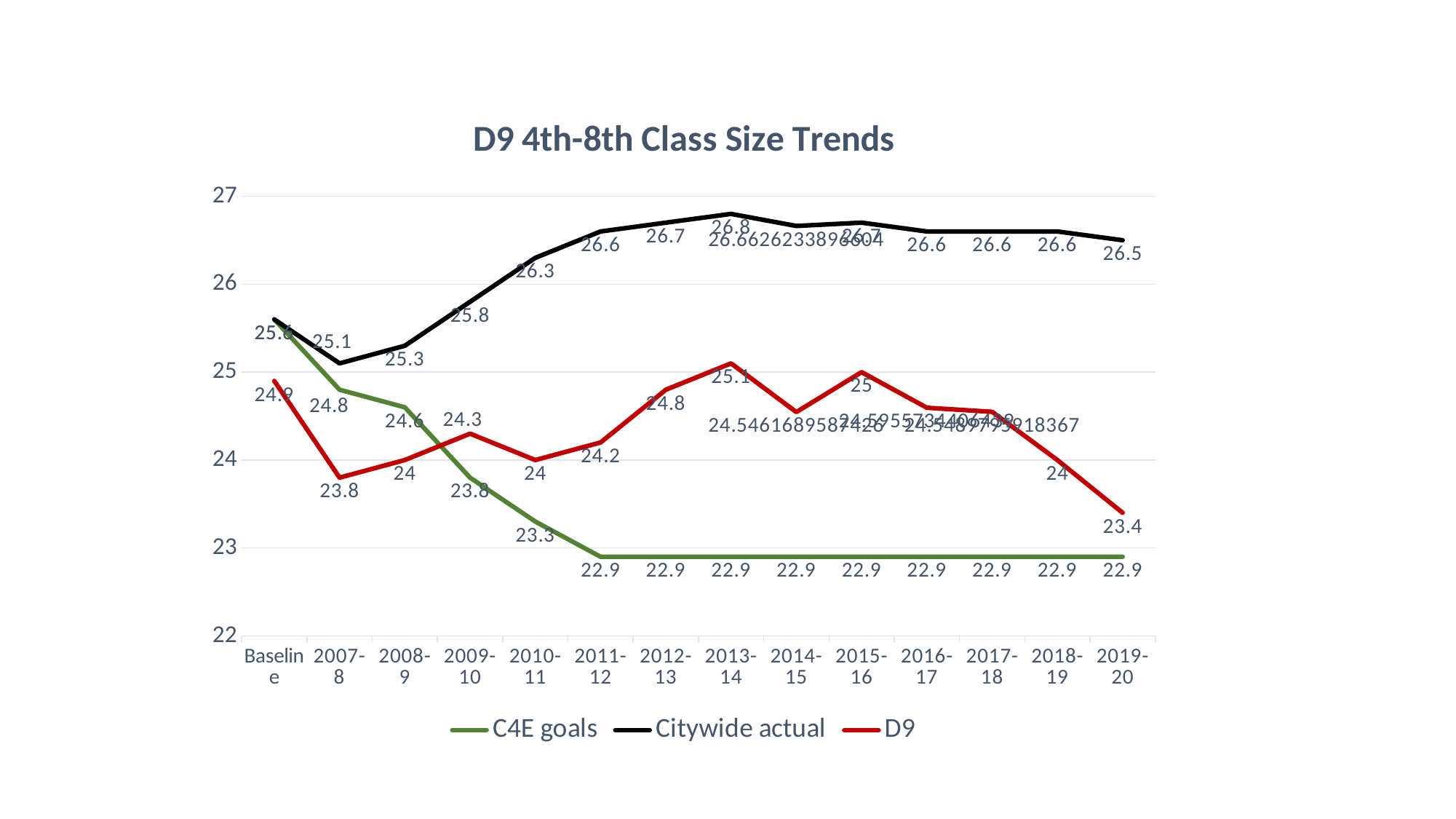
What is the D9 value for 2007-8? 23.8 What is the Citywide actual value for 2019-20? 26.5 How many categories are shown on the x axis? 14 What type of chart is shown on the slide? line chart In which year does the Citywide actual series reach its highest value? 2013-14 What is the D9 value for 2019-20? 23.4 In which year is the D9 value lowest? 2019-20 What is the difference between the Citywide actual and D9 values in 2019-20? 3.1 What is the C4E goals value for 2010-11? 23.3 In 2007-8, which is larger: Citywide actual or D9? Citywide actual How many series does the legend list? 3 What colour is the D9 line? red